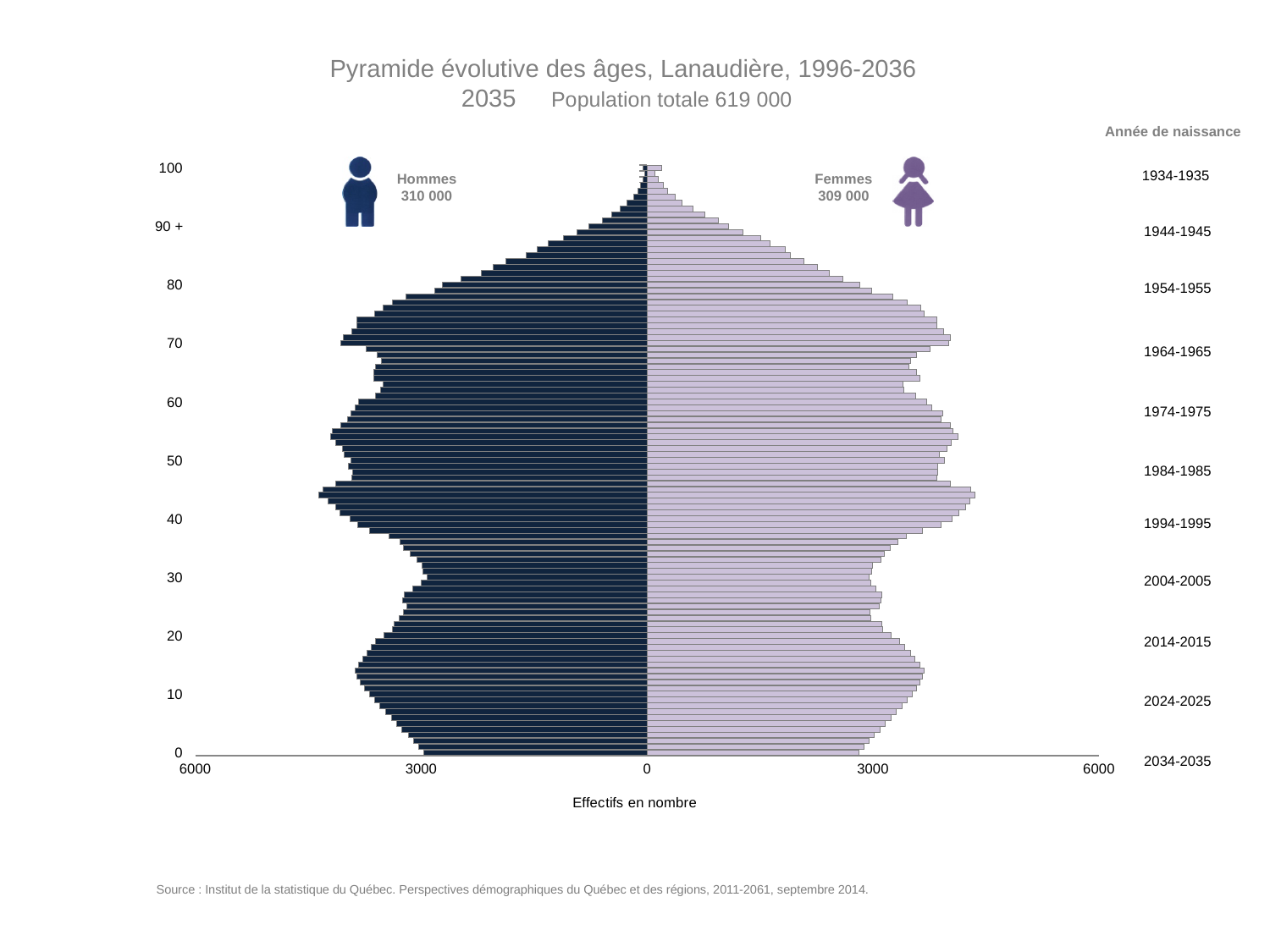
What is the title of the chart? Pyramide évolutive des âges, Lanaudière, 1996-2036 What is the total population shown on the chart? 619 000 How many series (population groups) does the chart show? 2 What year does the pyramid shown represent? 2035 Is the value for Femmes at age 90 greater or less than 3000? less Which group has the larger population, Hommes or Femmes? Hommes What is the label of the horizontal axis? Effectifs en nombre What is the difference between the Hommes population and the Femmes population? 1 000 Is the value for Hommes at age 45 greater or less than 3000? greater What kind of chart is shown on the slide? Bar chart (population pyramid) What is the population of Femmes shown on the chart? 309 000 What is the population of Hommes shown on the chart? 310 000